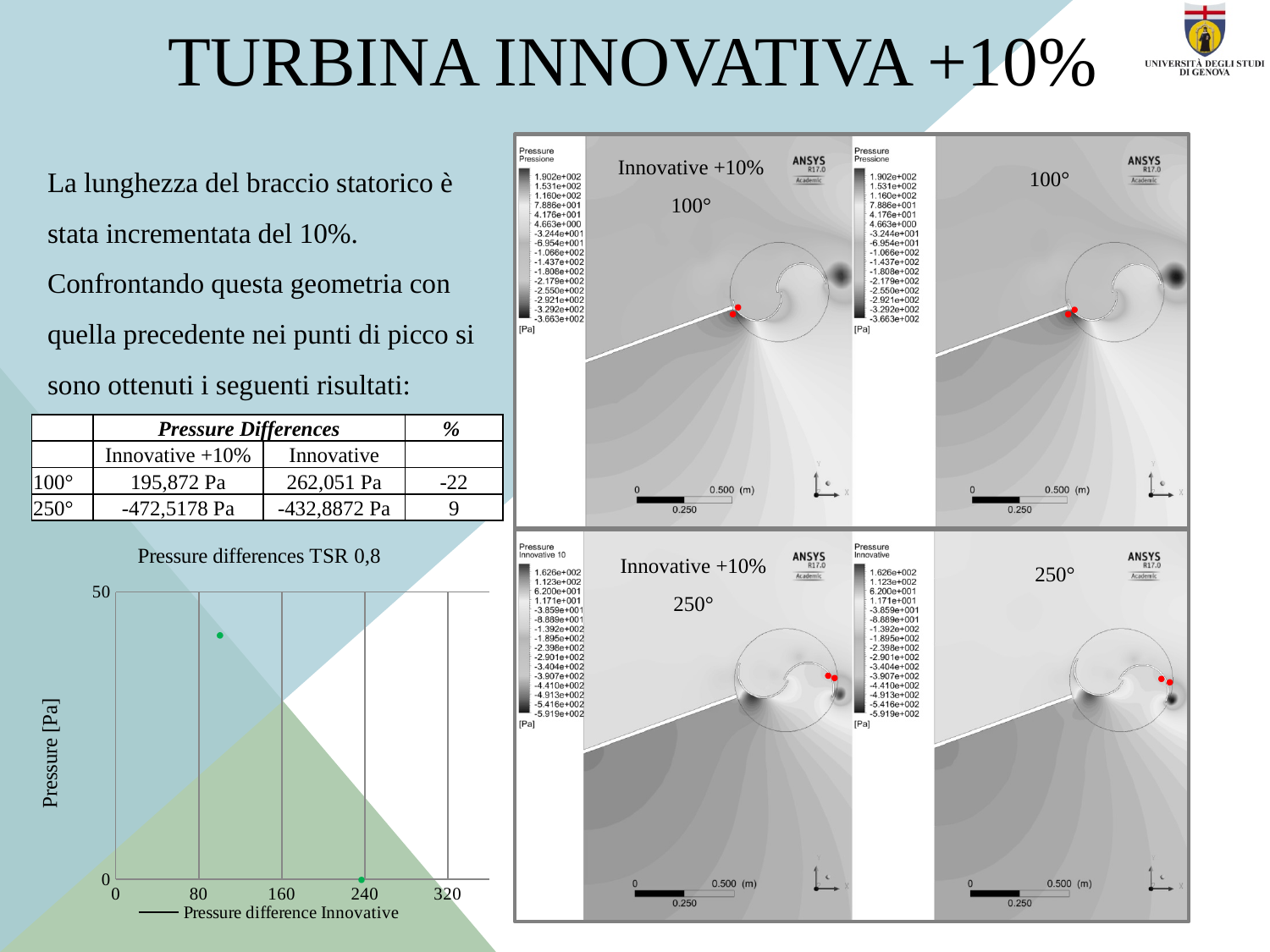
What entry does the legend of the 'Pressure differences TSR 0,8' chart list? Pressure difference Innovative In the 'Pressure differences TSR 0,8' chart, which point is higher: the one near x = 100 or the one near x = 240? the one near x = 100 In the 'Pressure differences TSR 0,8' chart, is the value of the point plotted near x = 100 greater or less than 50? less How many series does the legend of the 'Pressure differences TSR 0,8' chart list? 1 What is the highest tick value shown on the y axis of the 'Pressure differences TSR 0,8' chart? 50 What kind of chart is the 'Pressure differences TSR 0,8' chart? scatter chart What is the highest tick value shown on the x axis of the 'Pressure differences TSR 0,8' chart? 320 What is the title of the chart on the slide? Pressure differences TSR 0,8